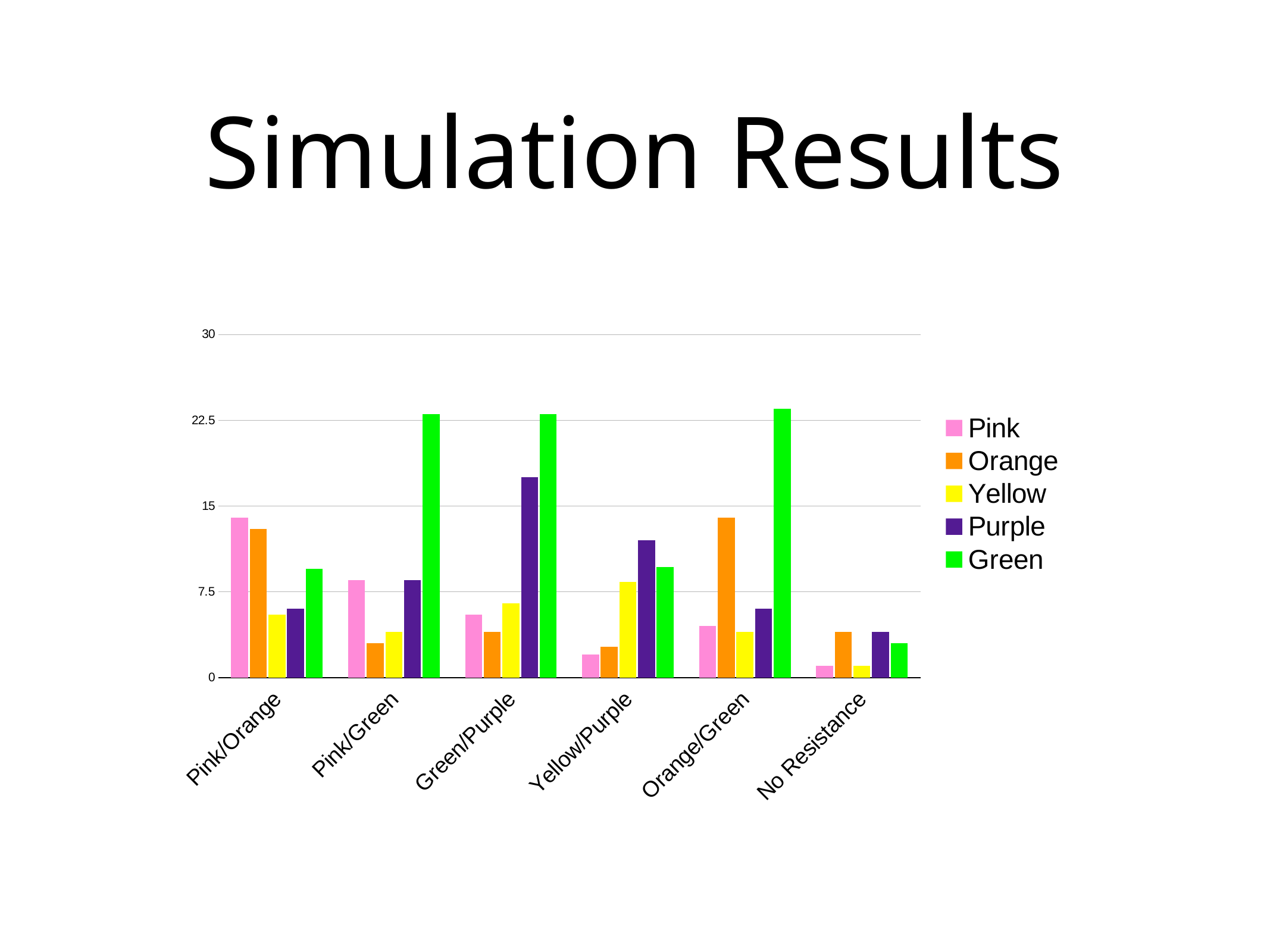
Which series has the highest value in the Yellow/Purple category? Purple Which is larger in the Yellow/Purple category, the Yellow value or the Pink value? Yellow Which series has the lowest value in the Pink/Orange category? Yellow What kind of chart is shown on the slide? bar chart How many categories are shown on the x axis? 6 Which is larger in the Orange/Green category, the Orange value or the Pink value? Orange How many series does the legend list? 5 Which series has the highest value in the Green/Purple category? Green Is the value for Purple in the Green/Purple category greater or less than 15? greater What is the title of the slide containing the chart? Simulation Results Is the value for Orange in the Orange/Green category greater or less than 15? less Is the value for Green in the Pink/Green category greater or less than 22.5? greater